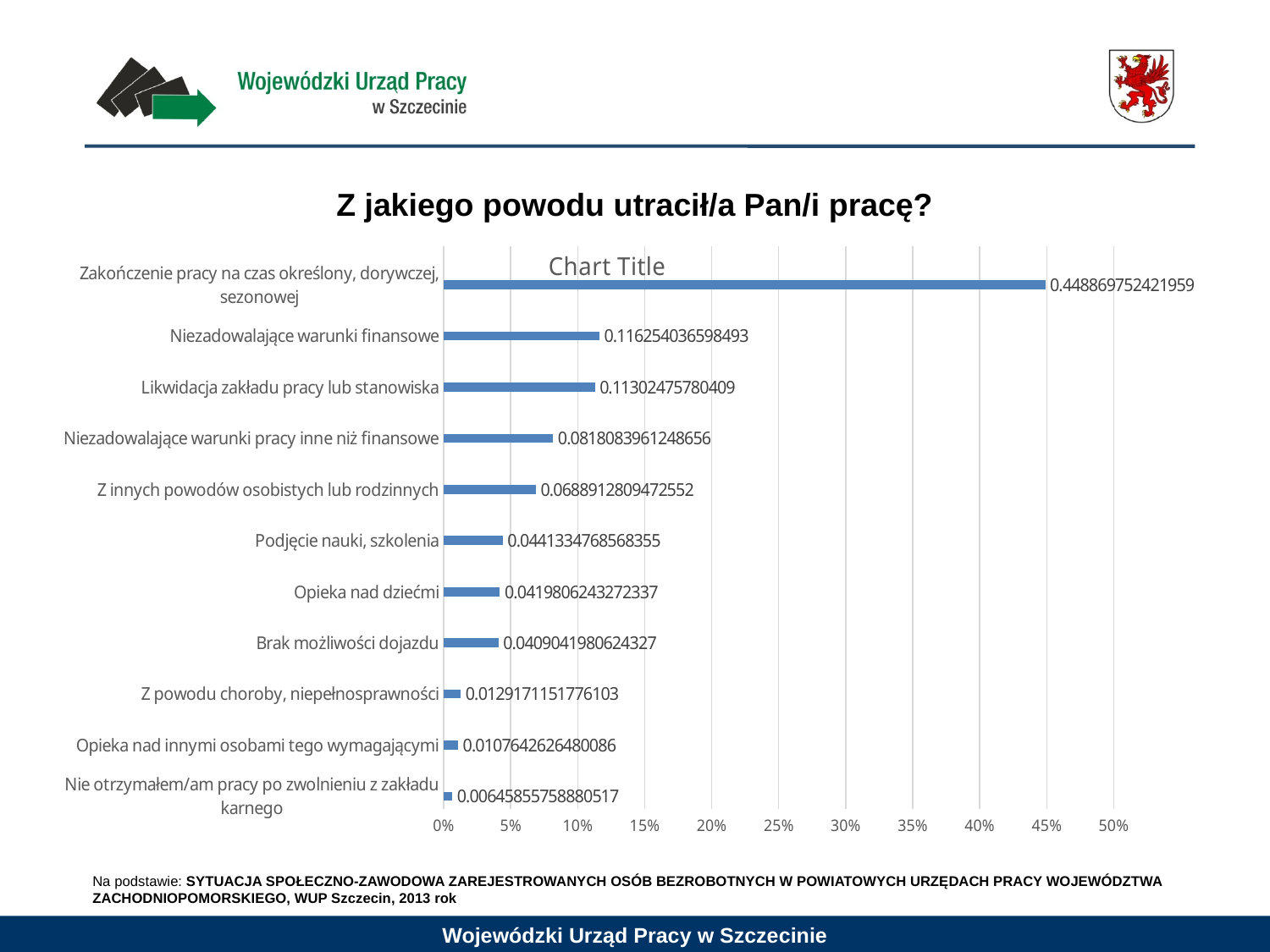
Is the value for 'Podjęcie nauki, szkolenia' greater or less than 5%? less Which category has the lowest value? Nie otrzymałem/am pracy po zwolnieniu z zakładu karnego What kind of chart is shown on the slide? bar chart Which category has the highest value? Zakończenie pracy na czas określony, dorywczej, sezonowej Which is larger: 'Niezadowalające warunki pracy inne niż finansowe' or 'Z innych powodów osobistych lub rodzinnych'? Niezadowalające warunki pracy inne niż finansowe What is the value for 'Z powodu choroby, niepełnosprawności'? 0.0129171151776103 Is the value for 'Zakończenie pracy na czas określony, dorywczej, sezonowej' greater or less than 40%? greater What is the value for 'Likwidacja zakładu pracy lub stanowiska'? 0.11302475780409 What is the title printed inside the chart area? Chart Title How many categories are shown in the chart? 11 What is the value for 'Zakończenie pracy na czas określony, dorywczej, sezonowej'? 0.448869752421959 What is the value for 'Opieka nad dziećmi'? 0.0419806243272337